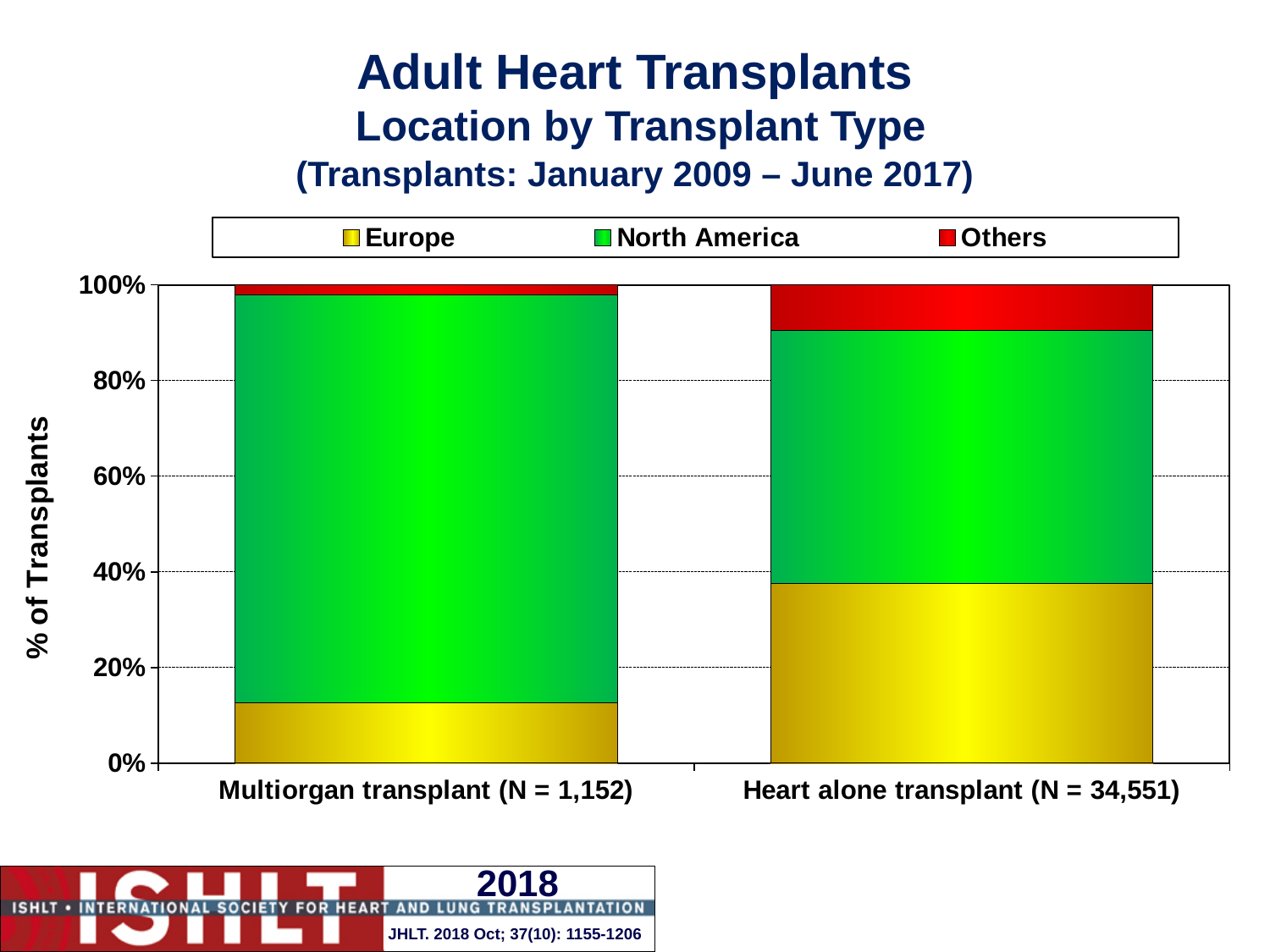
Which series are listed in the legend? Europe, North America, Others Is the Europe share for Heart alone transplant greater or less than 40%? less Which transplant type has the larger Others share, Multiorgan transplant or Heart alone transplant? Heart alone transplant What kind of chart is shown on the slide? Stacked bar chart What is the label of the y axis? % of Transplants How many series does the legend list? 3 Which transplant type has the larger Europe share, Multiorgan transplant or Heart alone transplant? Heart alone transplant Which transplant type has the larger North America share, Multiorgan transplant or Heart alone transplant? Multiorgan transplant Is the Europe share for Heart alone transplant greater or less than 20%? greater Is the Europe share for Multiorgan transplant greater or less than 20%? less What is the N value given for the Heart alone transplant category? 34,551 How many transplant type categories are shown on the x axis? 2